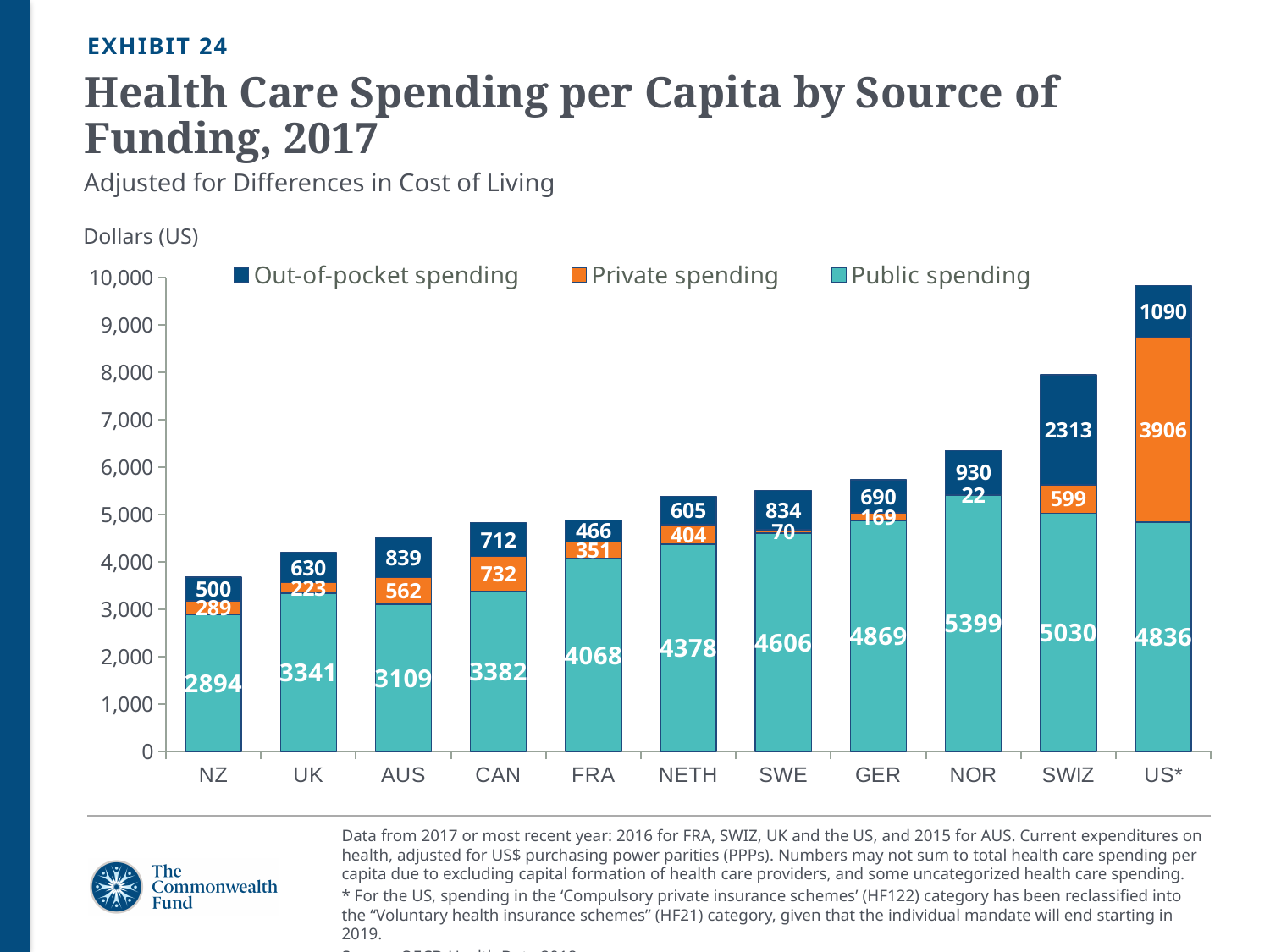
What is the private spending value for US*? 3906 Which colour represents public spending in the chart? Teal How many series does the legend list? 3 What is the difference between the public spending of NOR and NZ? 2505 What is the public spending value for NOR? 5399 Which country has the lowest public spending? NZ What is the out-of-pocket spending value for SWIZ? 2313 What kind of chart is shown on the slide? Stacked bar chart How many countries are shown on the x axis? 11 What is the total of the stacked bar for US*? 9832 Which country has the highest out-of-pocket spending? SWIZ Which is larger, the private spending of CAN or of AUS? CAN